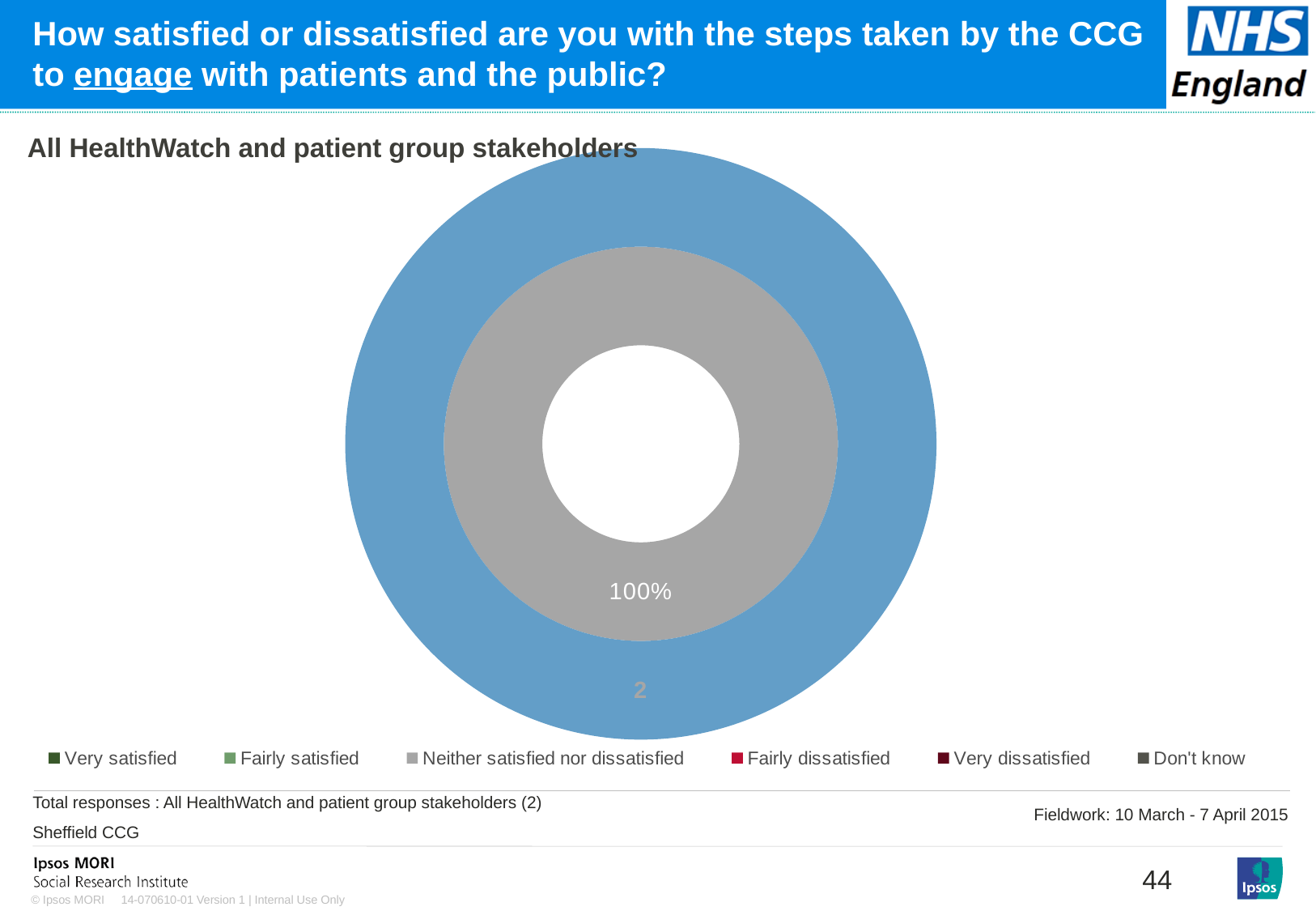
According to the legend, which response category does the grey segment labelled 100% represent? Neither satisfied nor dissatisfied What number is printed in the blue outer ring of the chart? 2 What percentage is labelled on the grey segment of the doughnut chart? 100% How many segments with a printed percentage label appear in the doughnut chart? 1 Which stakeholder group does the chart cover, according to the heading above it? All HealthWatch and patient group stakeholders Which legend entry is shown in grey? Neither satisfied nor dissatisfied What share of the doughnut chart is taken by 'Neither satisfied nor dissatisfied'? 100% What kind of chart is shown on the slide? Doughnut (pie) chart How many response categories does the legend list? 6 Which response category is the largest in the chart? Neither satisfied nor dissatisfied How many total responses are stated for All HealthWatch and patient group stakeholders? 2